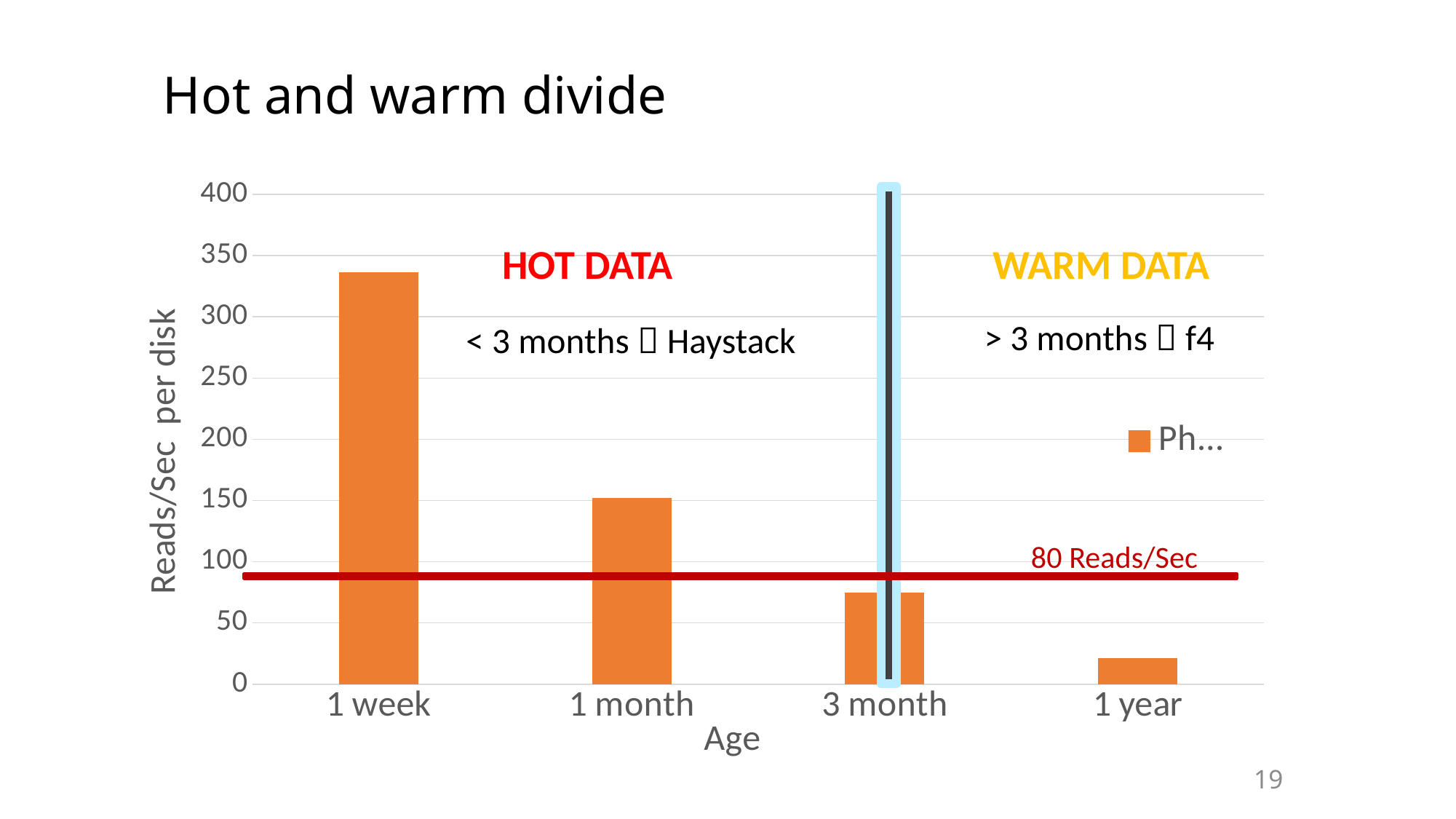
Which age category has the highest reads per second per disk? 1 week Is the value for 1 week greater or less than 300? greater Do the values rise or fall as age increases along the x axis? fall How many age categories are shown on the x axis? 4 Is the value for 3 month greater or less than 100? less Which age category has the lowest reads per second per disk? 1 year Is the value for 1 month greater or less than 100? greater Which has a higher value, 3 month or 1 year? 3 month What is the label on the y axis of the chart? Reads/Sec per disk Which has a higher value, 1 week or 1 month? 1 week What kind of chart is shown on the slide? bar chart